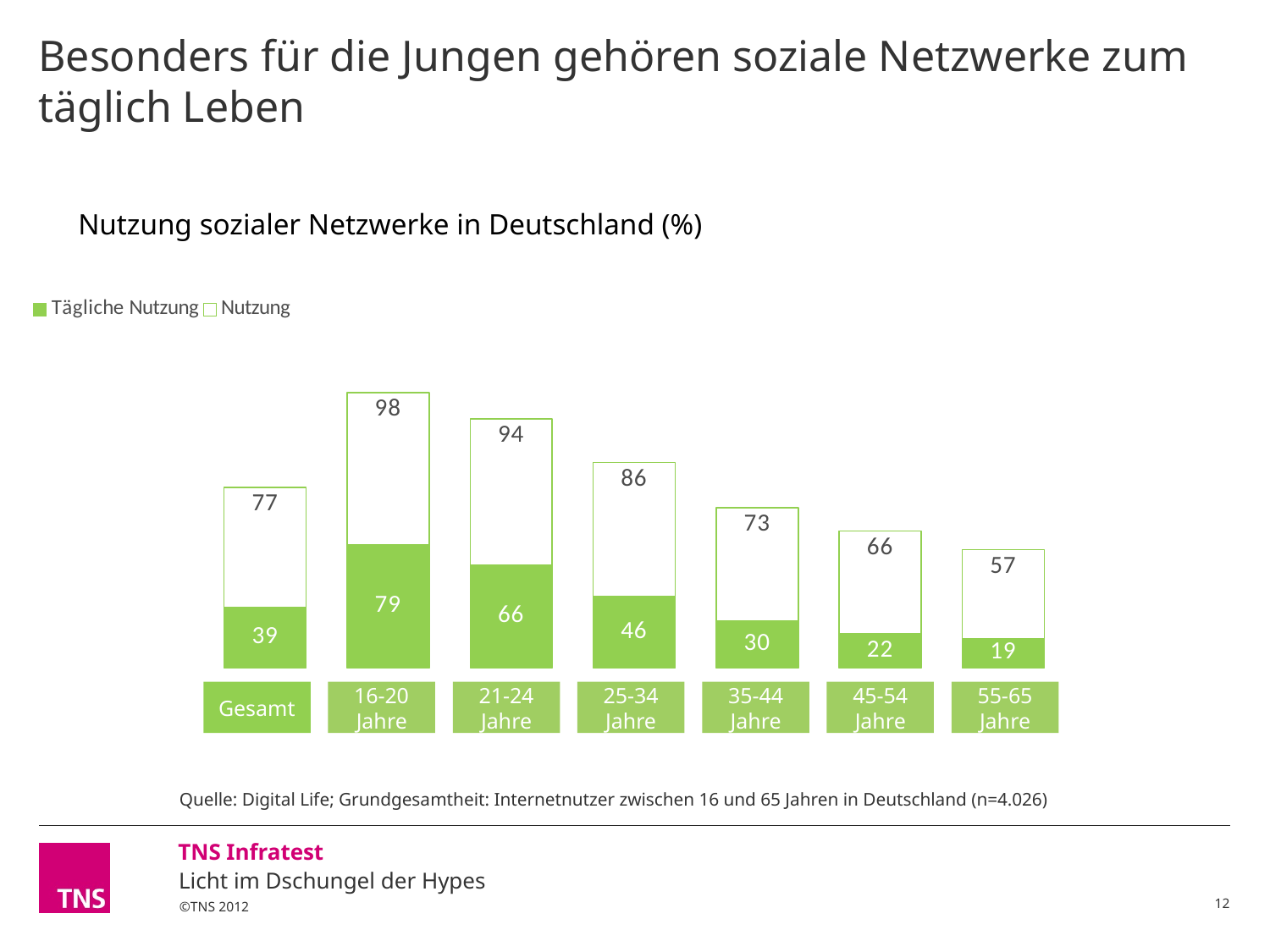
What kind of chart is shown on the slide? bar chart Which age group has the highest Nutzung value? 16-20 Jahre How many series does the legend list? 2 What is the value of Tägliche Nutzung for the 16-20 Jahre group? 79 Which is larger: Tägliche Nutzung for 21-24 Jahre or Tägliche Nutzung for 35-44 Jahre? 21-24 Jahre What is the value of Tägliche Nutzung for Gesamt? 39 What is the title of the chart? Nutzung sozialer Netzwerke in Deutschland (%) Which age group has the lowest Tägliche Nutzung value? 55-65 Jahre What is the value of Nutzung for the 55-65 Jahre group? 57 What is the difference between Nutzung and Tägliche Nutzung for the 25-34 Jahre group? 40 Do the Nutzung values rise or fall across the age groups from 16-20 Jahre to 55-65 Jahre? fall How many categories are shown on the x axis? 7